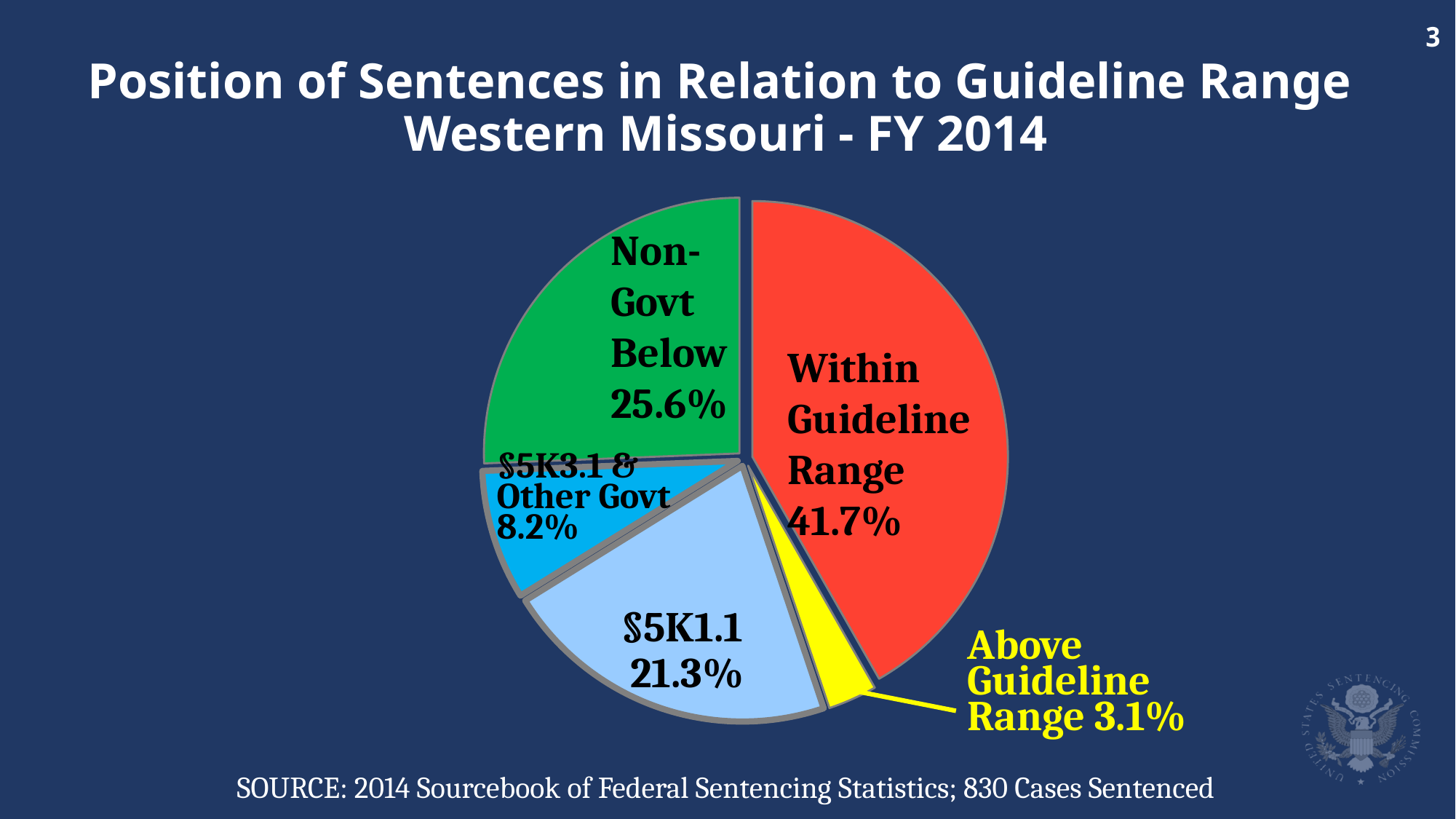
Which category has the largest share of the pie? Within Guideline Range How many slices does the pie chart have? 5 What percentage of sentences were §5K1.1? 21.3% What kind of chart is shown on the slide? pie chart How many cases were sentenced according to the source note? 830 Which category has the smallest share of the pie? Above Guideline Range What percentage of sentences were Above Guideline Range? 3.1% What percentage of sentences were §5K3.1 & Other Govt? 8.2% What is the difference in percentage points between Within Guideline Range and Non-Govt Below? 16.1 What percentage of sentences were Non-Govt Below? 25.6% Which is larger, the §5K1.1 share or the §5K3.1 & Other Govt share? §5K1.1 What percentage of sentences were Within Guideline Range? 41.7%